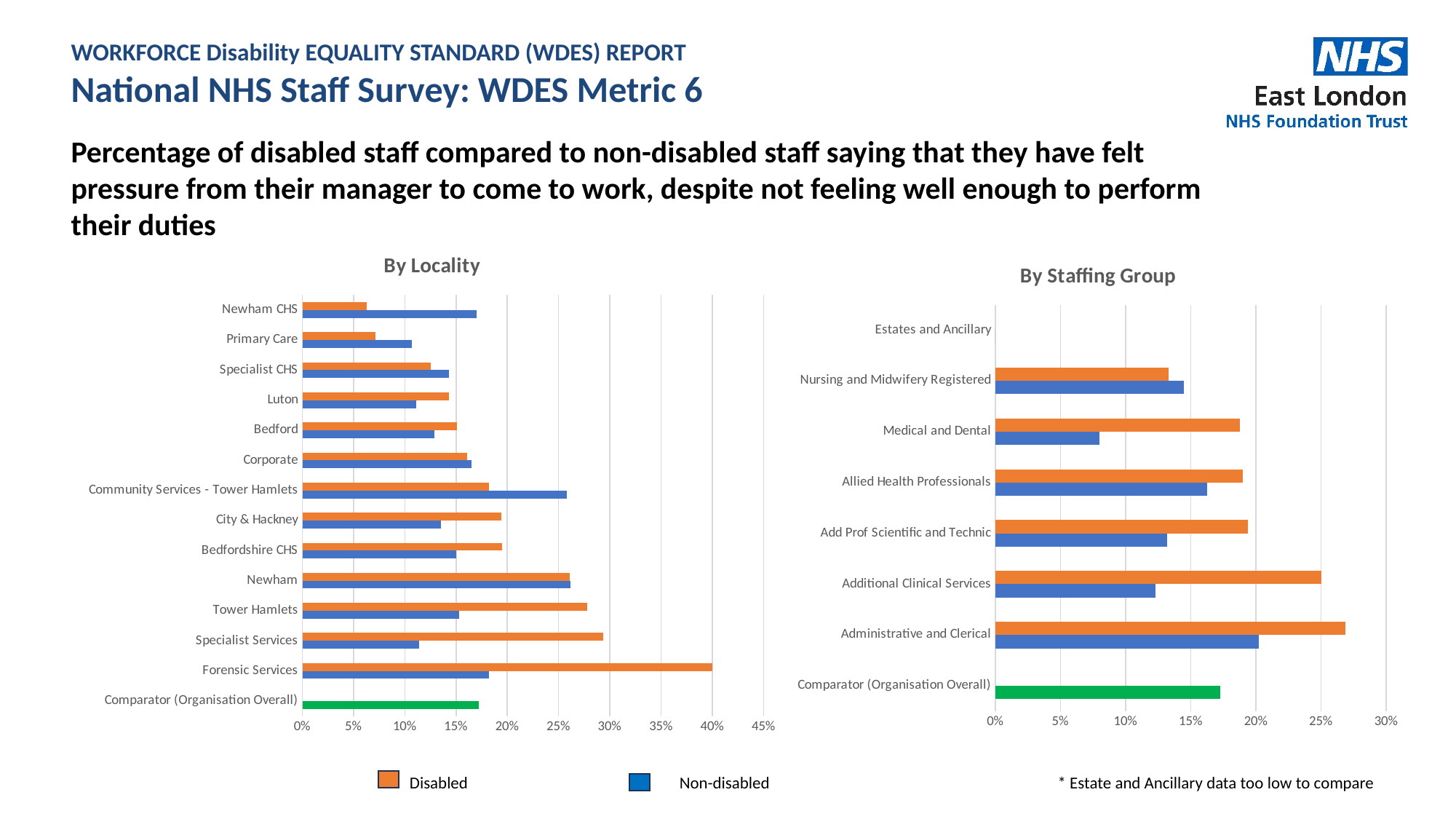
In the 'By Locality' chart, is the Disabled value for Forensic Services greater or less than 35%? greater How many categories are listed on the y axis of the 'By Staffing Group' chart? 8 How many categories are listed on the y axis of the 'By Locality' chart? 14 What kind of chart is the 'By Locality' chart? bar chart According to the legend, which series is shown in orange? Disabled In the 'By Locality' chart, is the Disabled value for Newham CHS greater or less than 10%? less In the 'By Staffing Group' chart, which staffing group has the highest Disabled value? Administrative and Clerical In the 'By Staffing Group' chart, is the Disabled value for Administrative and Clerical greater or less than 25%? greater In the 'By Staffing Group' chart, for Medical and Dental, which is larger: the Disabled value or the Non-disabled value? Disabled In the 'By Locality' chart, for Community Services - Tower Hamlets, which is larger: the Disabled value or the Non-disabled value? Non-disabled In the 'By Staffing Group' chart, which staffing group has the lowest Non-disabled value among those with bars plotted? Medical and Dental In the 'By Locality' chart, which locality has the highest Disabled value? Forensic Services